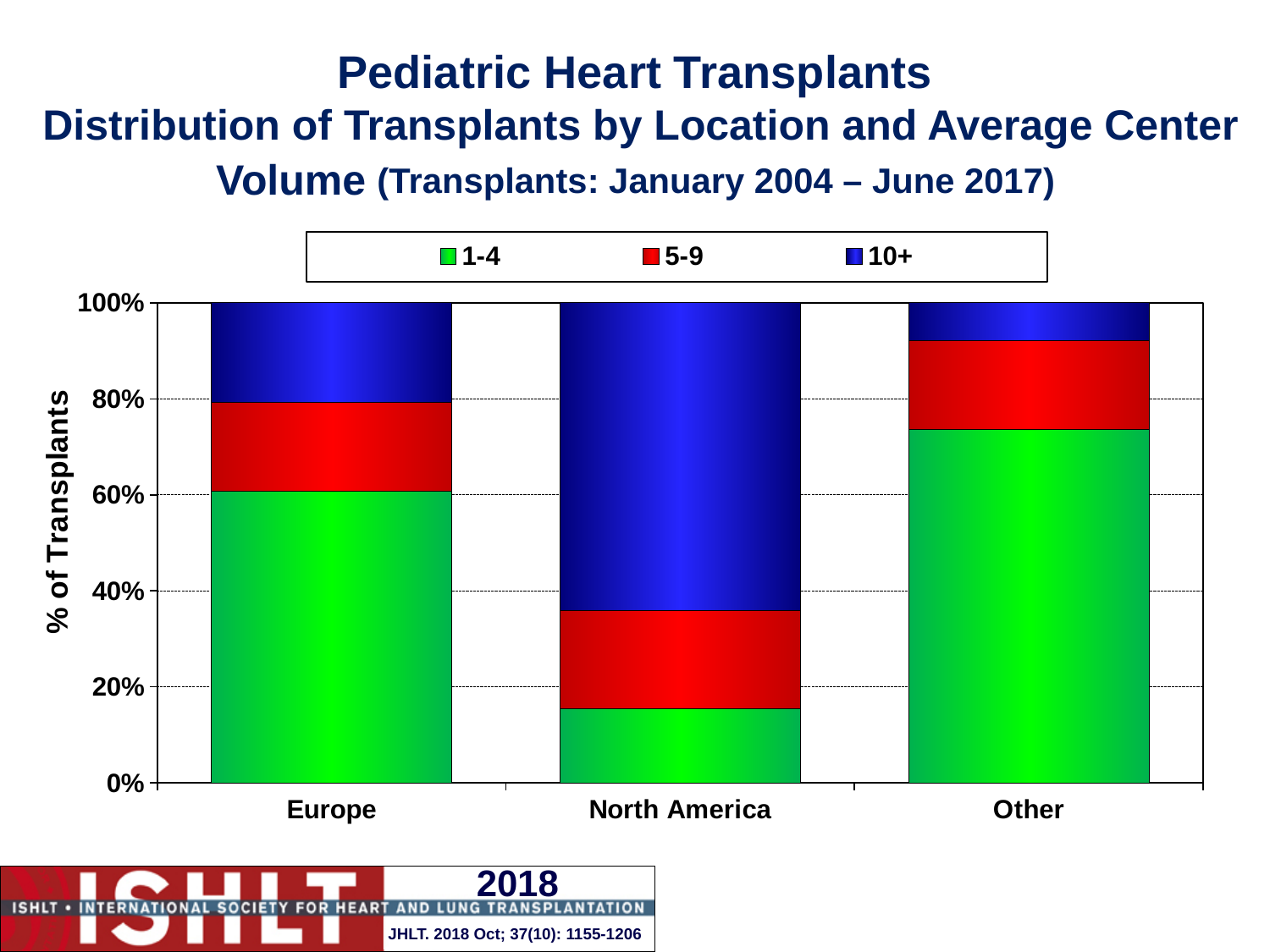
What is the label on the y axis of the chart? % of Transplants How many series does the legend list? 3 Which location has the smallest share of transplants in the 1-4 center volume group? North America What kind of chart is shown on the slide? Stacked bar chart Which location has the largest share of transplants in the 1-4 center volume group? Other Which location has the largest share of transplants in the 10+ center volume group? North America Which location has the smallest share of transplants in the 10+ center volume group? Other Is the 1-4 share for North America greater or less than 20%? less Which has a larger 1-4 share, Europe or North America? Europe Is the 1-4 share for Europe greater or less than 40%? greater How many locations are shown on the x axis of the chart? 3 Is the 1-4 share for Other greater or less than 60%? greater